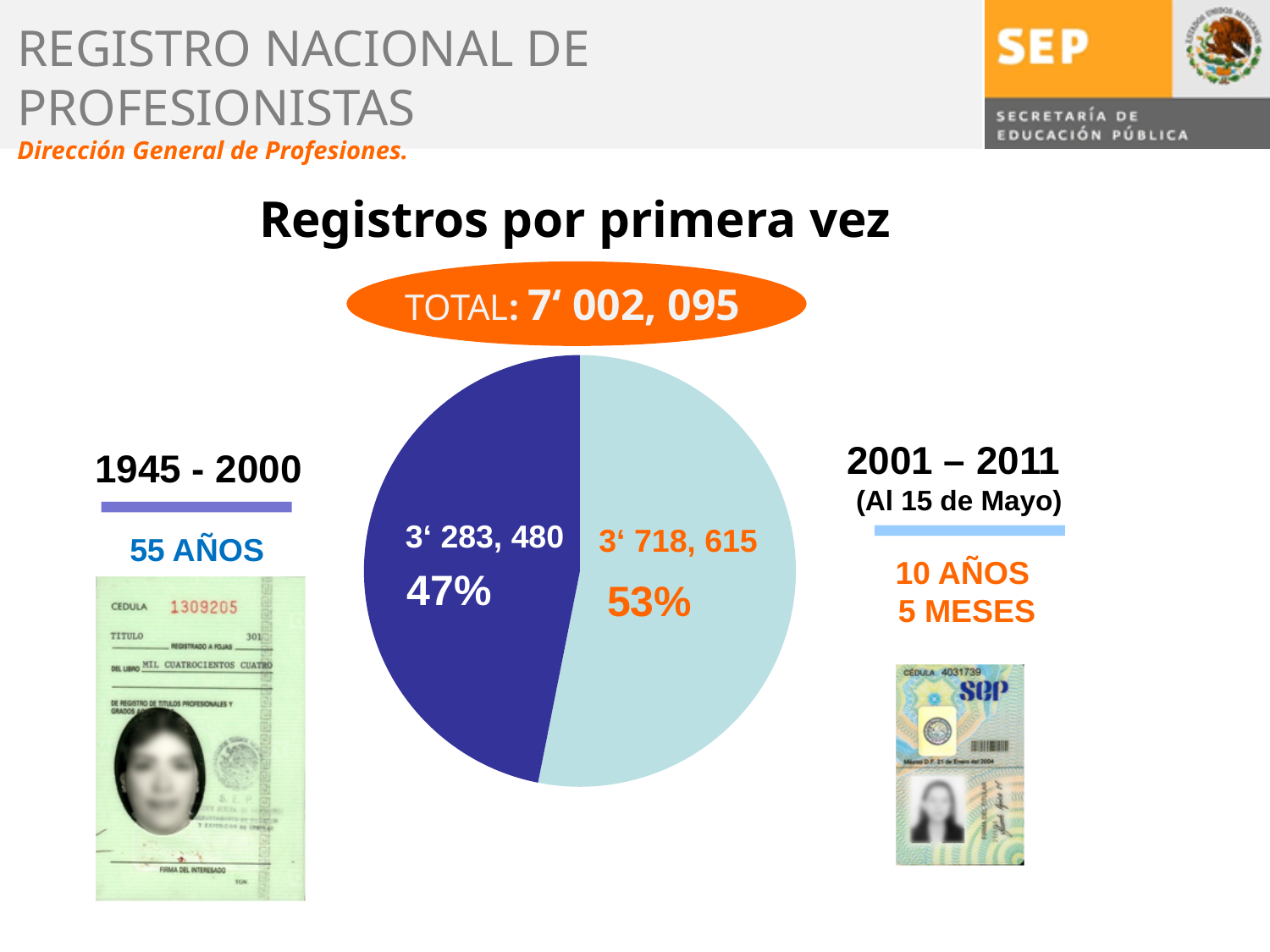
What percentage share of the pie does the 1945 - 2000 period represent? 47% Is the value for 2001 – 2011 larger or smaller than the value for 1945 - 2000? larger Which period has the larger slice of the pie chart? 2001 – 2011 How many slices does the pie chart have? 2 What is the total of registrations shown above the pie chart? 7' 002, 095 What is the title of the chart on the slide? Registros por primera vez What is the value shown for the 1945 - 2000 slice of the pie chart? 3' 283, 480 Which period has the smaller slice of the pie chart? 1945 - 2000 What kind of chart is shown on the slide? pie chart What colour is the slice for the 1945 - 2000 period? dark blue What is the value shown for the 2001 – 2011 slice of the pie chart? 3' 718, 615 What percentage share of the pie does the 2001 – 2011 period represent? 53%